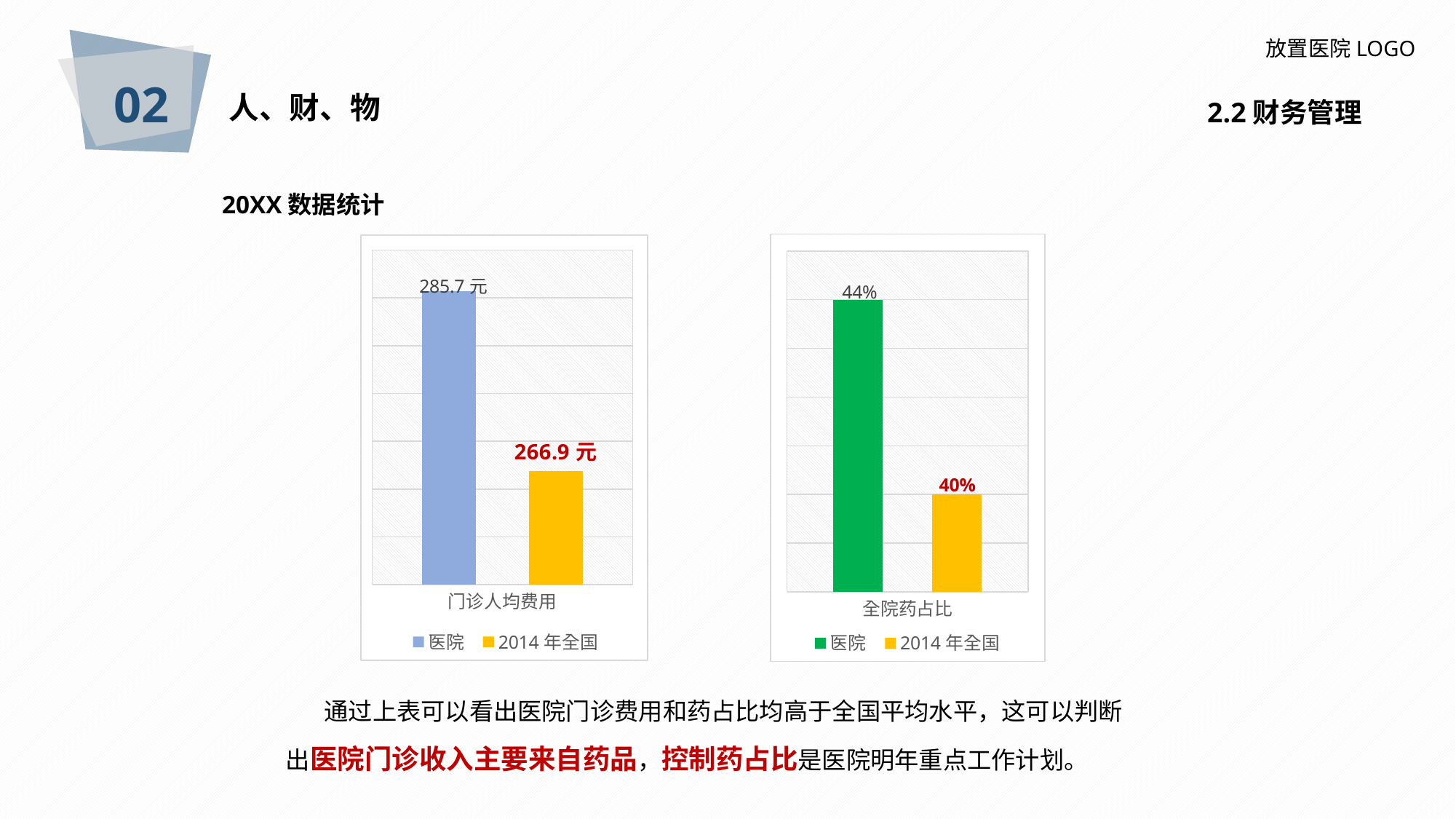
What kind of chart is the right chart (全院药占比)? bar chart In the right chart (全院药占比), which series has the lower value? 2014 年全国 In the right chart (全院药占比), what is the value for 医院? 44% In the left chart (门诊人均费用), what is the value for 2014 年全国? 266.9 元 In the left chart (门诊人均费用), what is the value for 医院? 285.7 元 In the right chart (全院药占比), what is the difference between the 医院 value and the 2014 年全国 value? 4% In the right chart (全院药占比), is the value for 医院 larger or smaller than the value for 2014 年全国? larger In the right chart (全院药占比), what colour is the bar for 医院? green How many series does the legend of the left chart (门诊人均费用) list? 2 In the right chart (全院药占比), what is the value for 2014 年全国? 40% In the left chart (门诊人均费用), which series has the higher value? 医院 In the left chart (门诊人均费用), what is the difference between the 医院 value and the 2014 年全国 value? 18.8 元